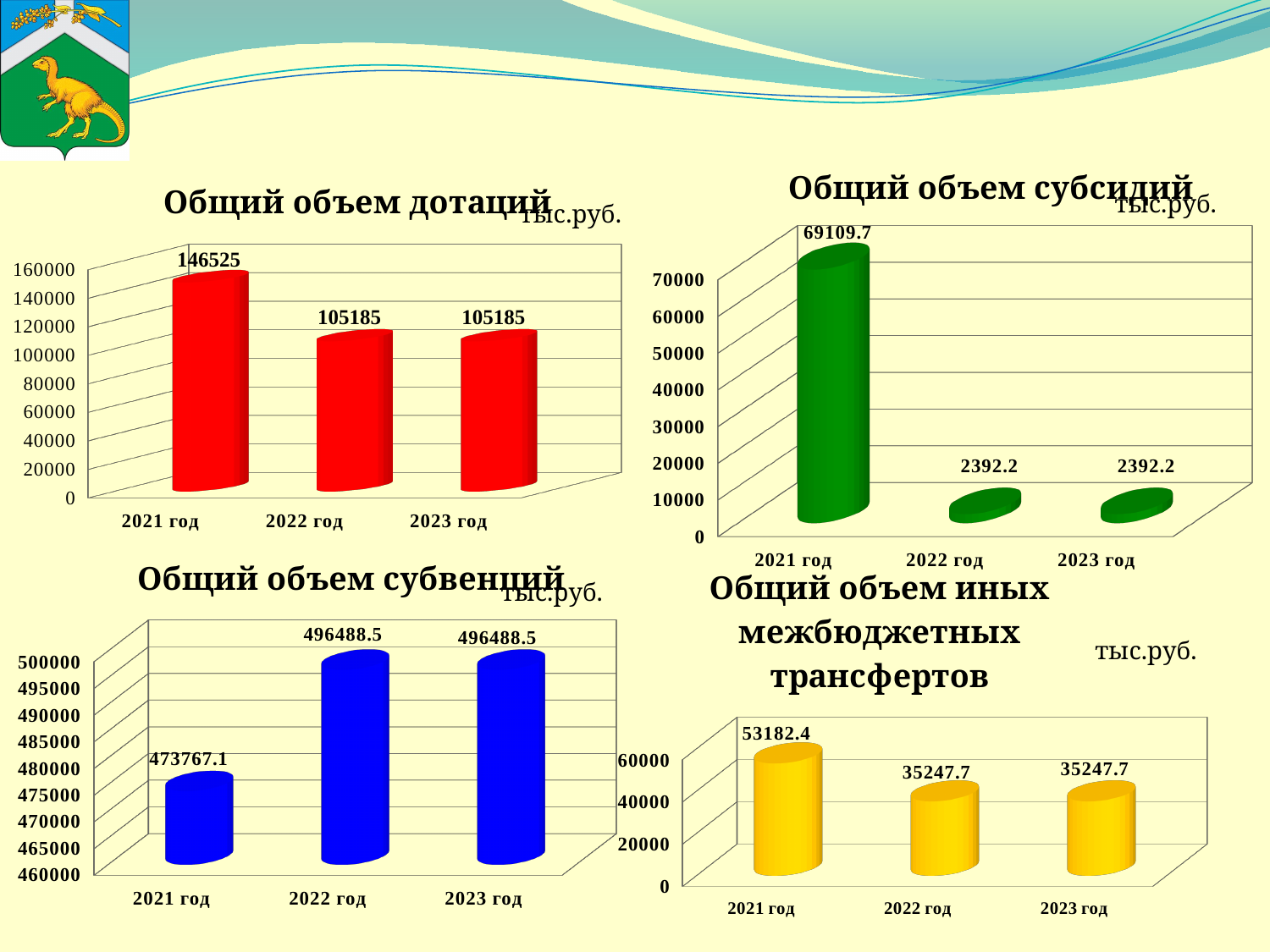
In the chart 'Общий объем субвенций', what is the value for 2021 год? 473767.1 In the chart 'Общий объем иных межбюджетных трансфертов', what is the value for 2023 год? 35247.7 In the chart 'Общий объем иных межбюджетных трансфертов', what is the difference between the values for 2021 год and 2022 год? 17934.7 In the chart 'Общий объем дотаций', what is the value for 2021 год? 146525 In the chart 'Общий объем субсидий', is the value for 2021 год greater or less than 60000? greater In the chart 'Общий объем субсидий', what is the value for 2022 год? 2392.2 In the chart 'Общий объем субвенций', which is larger: the value for 2021 год or 2022 год? 2022 год In the chart 'Общий объем субвенций', which year has the lowest value? 2021 год What kind of chart is 'Общий объем иных межбюджетных трансфертов'? bar chart In the chart 'Общий объем дотаций', what is the difference between the values for 2021 год and 2022 год? 41340 In the chart 'Общий объем субсидий', which year has the highest value? 2021 год How many categories (years) are shown in the chart 'Общий объем дотаций'? 3